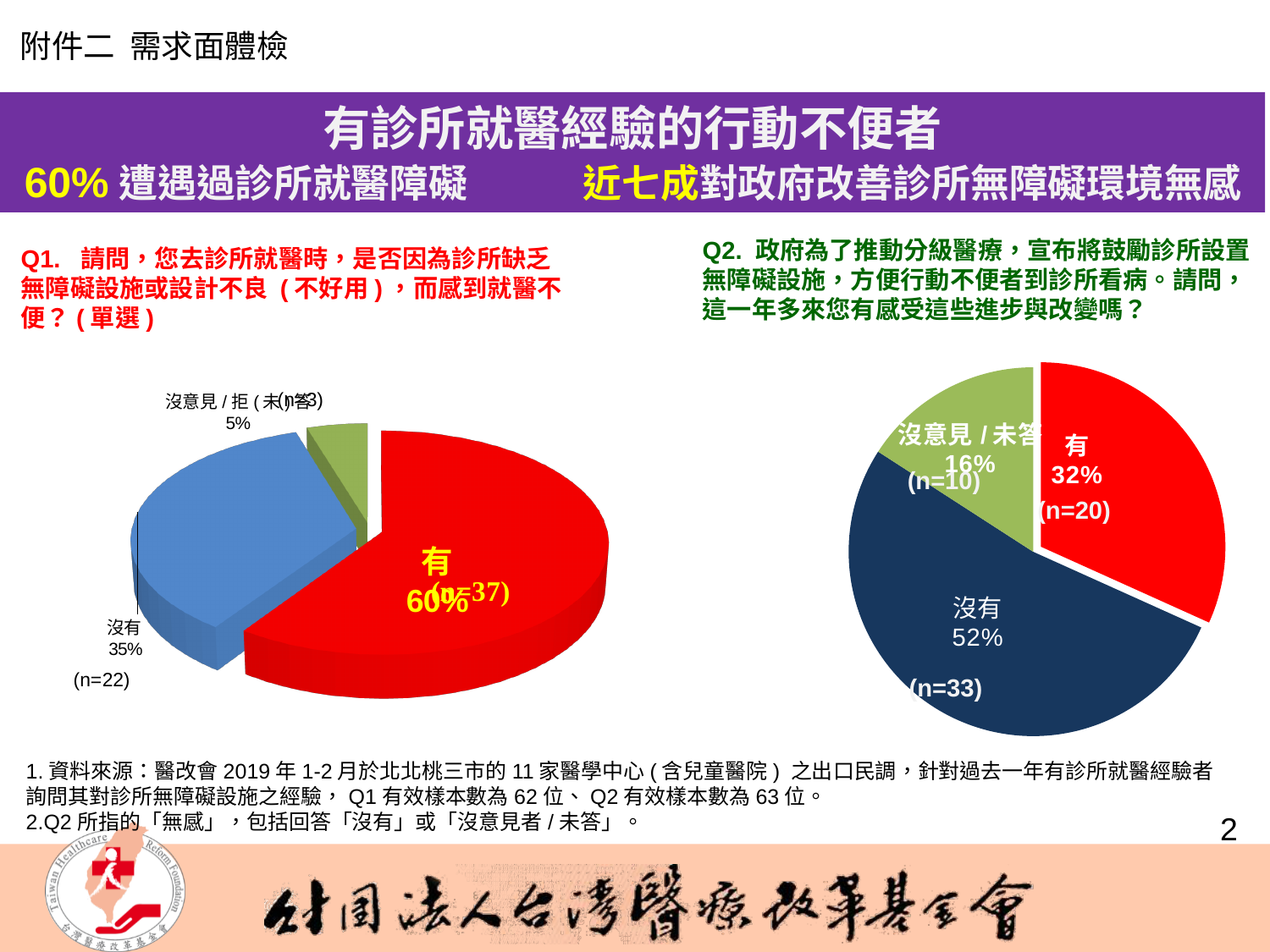
In the left pie chart (Q1), what percentage of respondents answered 沒有? 35% In the left pie chart (Q1), what is the sample count (n) for the 沒有 slice? n=22 In the right pie chart (Q2), what is the difference in percentage points between 沒有 and 有? 20 In the left pie chart (Q1), which category has the smallest share? 沒意見/拒(未)答 How many slices does the right pie chart (Q2) have? 3 In the right pie chart (Q2), which category has the largest share? 沒有 In the left pie chart (Q1), which is larger, the share for 有 or the share for 沒有? 有 In the right pie chart (Q2), what percentage of respondents answered 沒有? 52% In the left pie chart (Q1), what percentage of respondents answered 有? 60% In the right pie chart (Q2), what percentage of respondents answered 有? 32% What type of chart is used on the left side of the slide (Q1)? Pie chart In the right pie chart (Q2), what is the sample count (n) for the 沒意見/未答 slice? n=10